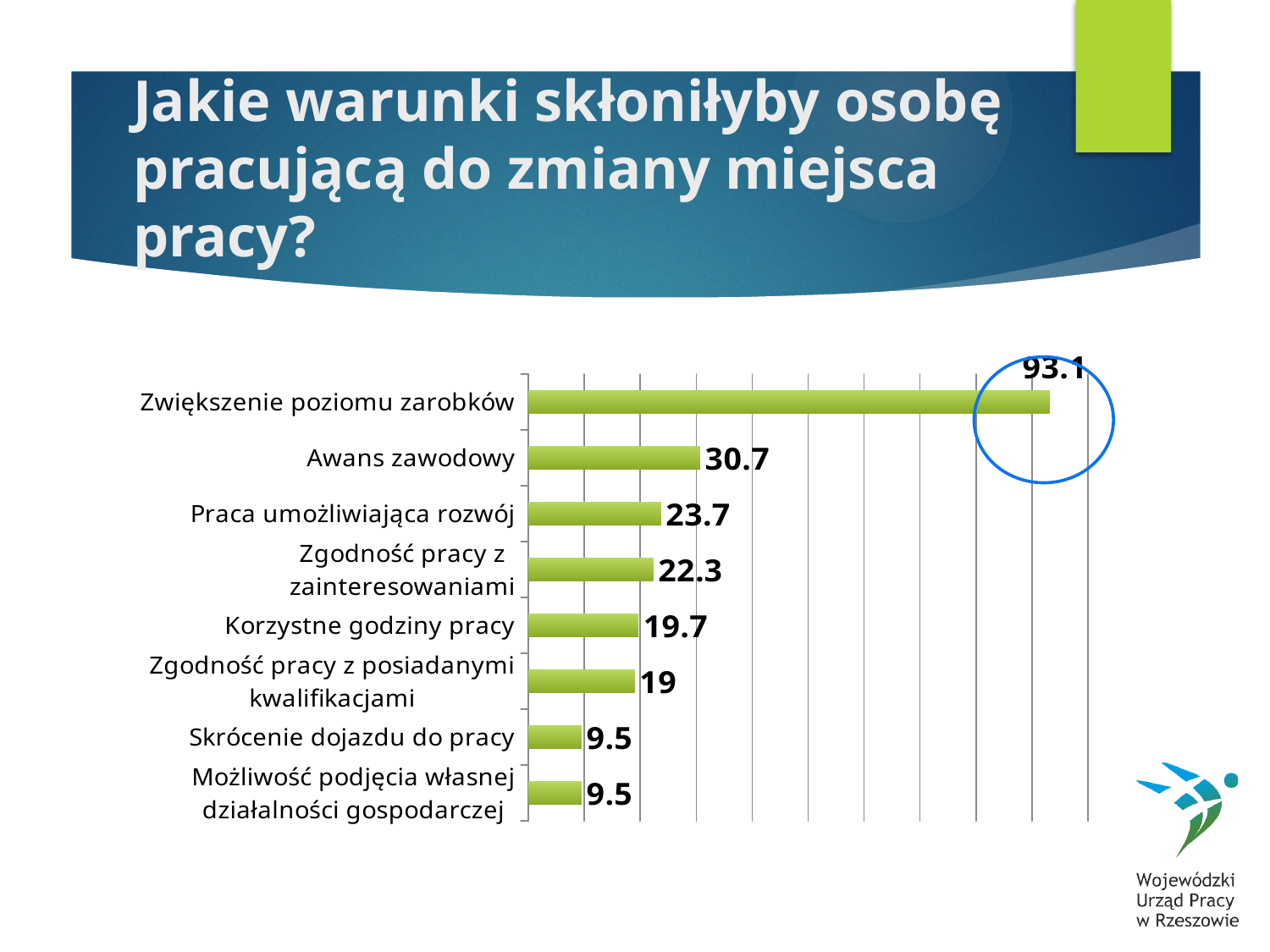
What value is shown for Korzystne godziny pracy? 19.7 What is the difference between the values for Zwiększenie poziomu zarobków and Awans zawodowy? 62.4 What is the difference between the values for Praca umożliwiająca rozwój and Zgodność pracy z zainteresowaniami? 1.4 What value is shown for Awans zawodowy? 30.7 How many categories are shown on the chart? 8 What value is shown for Zwiększenie poziomu zarobków? 93.1 What is the lowest value shown on the chart? 9.5 Which category has the highest value? Zwiększenie poziomu zarobków What kind of chart is shown on the slide? Bar chart What value is shown for Praca umożliwiająca rozwój? 23.7 Which is larger, the value for Awans zawodowy or the value for Korzystne godziny pracy? Awans zawodowy What value is shown for Zgodność pracy z posiadanymi kwalifikacjami? 19